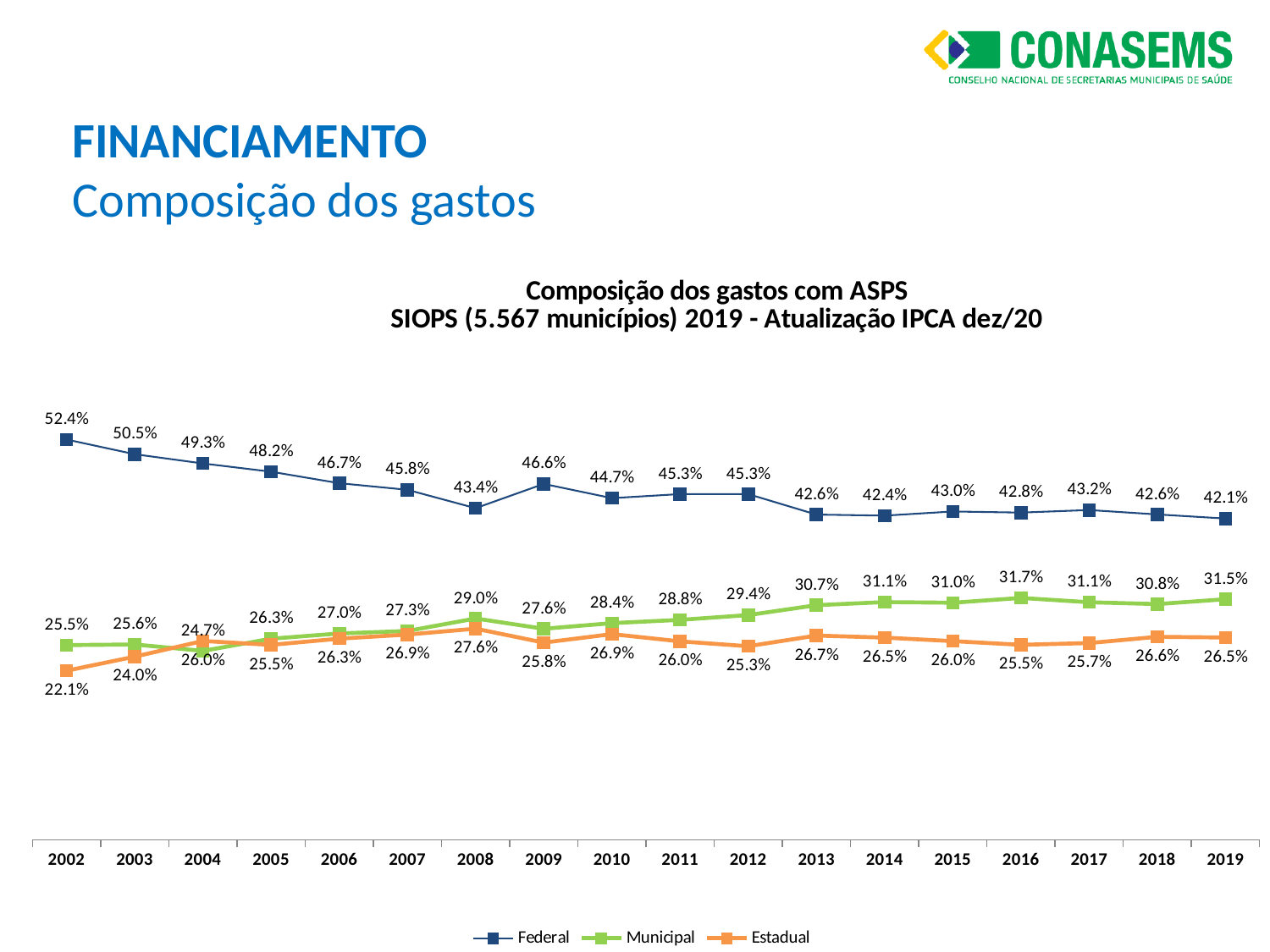
How many years are shown on the x axis? 18 What is the Federal share in 2002? 52.4% How many series does the legend list? 3 In which year is the Federal share highest? 2002 Does the Federal share generally rise or fall from 2002 to 2019? Fall In 2019, which is larger, the Municipal share or the Estadual share? Municipal By how many percentage points did the Federal share fall from 2002 to 2019? 10.3 percentage points In which year is the Estadual share lowest? 2002 In which year is the Municipal share highest? 2016 What is the Estadual share in 2002? 22.1% What is the Municipal share in 2019? 31.5% What kind of chart is this? Line chart